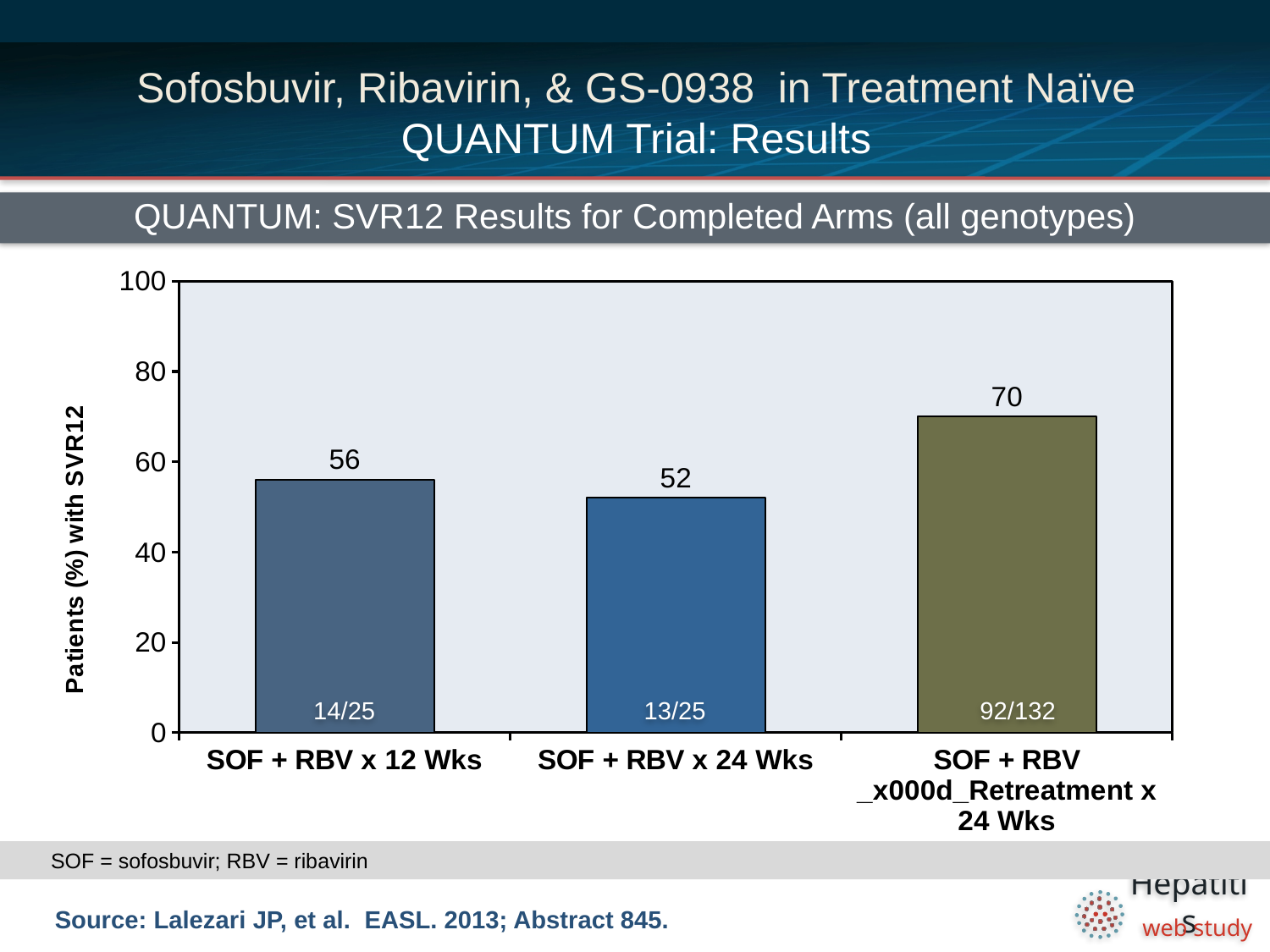
Which arm has the highest SVR12 rate? SOF + RBV Retreatment x 24 Wks Which has a higher SVR12 rate, SOF + RBV x 12 Wks or SOF + RBV x 24 Wks? SOF + RBV x 12 Wks Is the value for SOF + RBV Retreatment x 24 Wks greater or less than 60? greater What is the SVR12 value for SOF + RBV x 12 Wks? 56 What is the label of the y axis? Patients (%) with SVR12 What is the difference in SVR12 rate between SOF + RBV Retreatment x 24 Wks and SOF + RBV x 12 Wks? 14 What kind of chart is shown on the slide? bar chart How many treatment arms are shown in the chart? 3 Which arm has the lowest SVR12 rate? SOF + RBV x 24 Wks What is the SVR12 value for SOF + RBV Retreatment x 24 Wks? 70 What fraction of patients is printed inside the bar for SOF + RBV x 24 Wks? 13/25 What is the SVR12 value for SOF + RBV x 24 Wks? 52